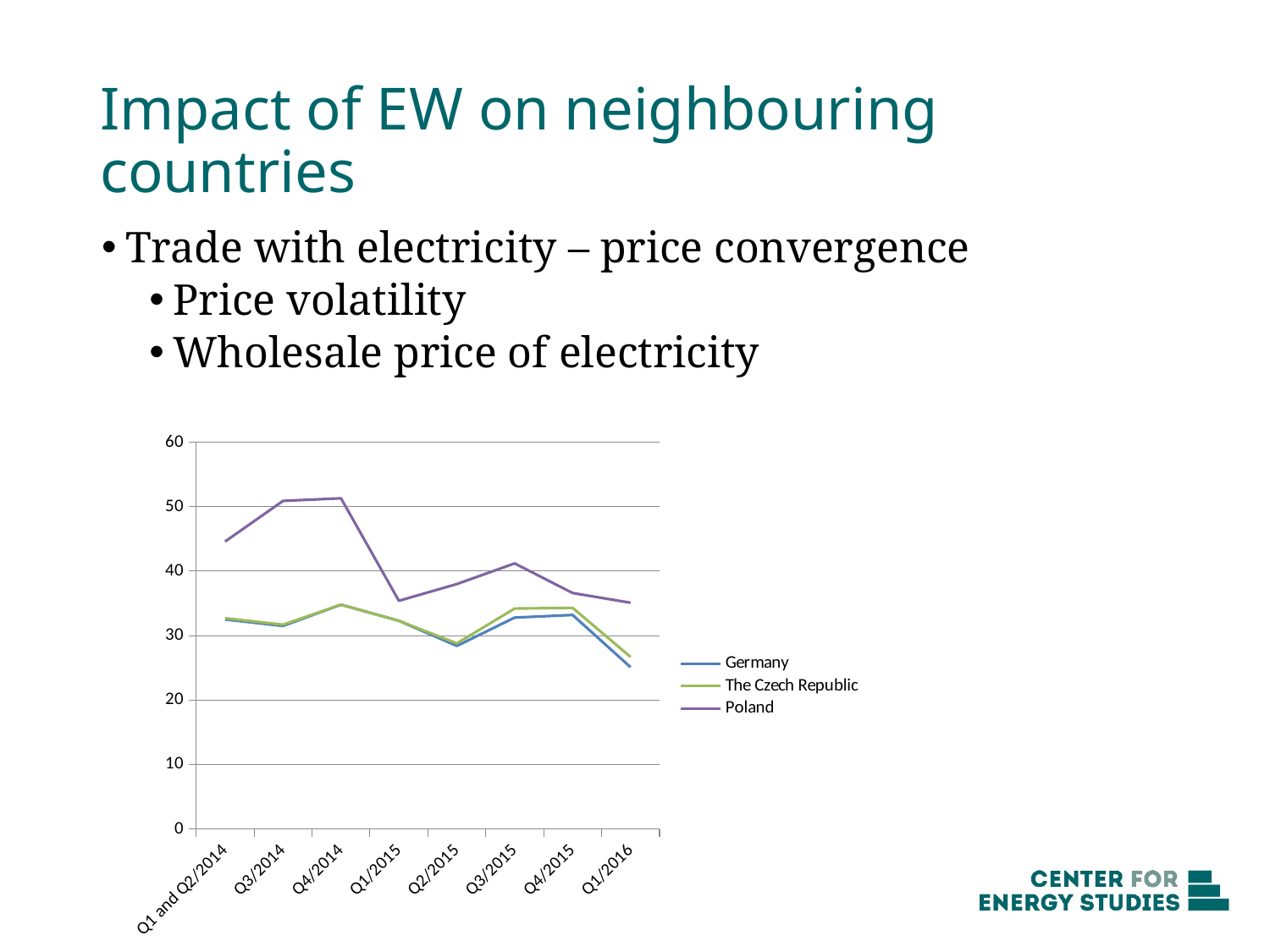
Is the value for Poland at Q4/2014 greater or less than 50? greater In which period does Germany reach its lowest value? Q1/2016 Is the value for Germany at Q1/2016 greater or less than 30? less Is the value for Poland at Q1/2015 greater or less than 40? less Which series is plotted with the purple line? Poland What kind of chart is shown on the slide? Line chart How many time periods are shown on the x axis of the chart? 8 Does the value for Poland rise or fall from Q4/2014 to Q1/2015? fall How many series does the chart's legend list? 3 At Q4/2014, which is larger: the value for Poland or the value for Germany? Poland Which series has the highest values across the whole chart? Poland